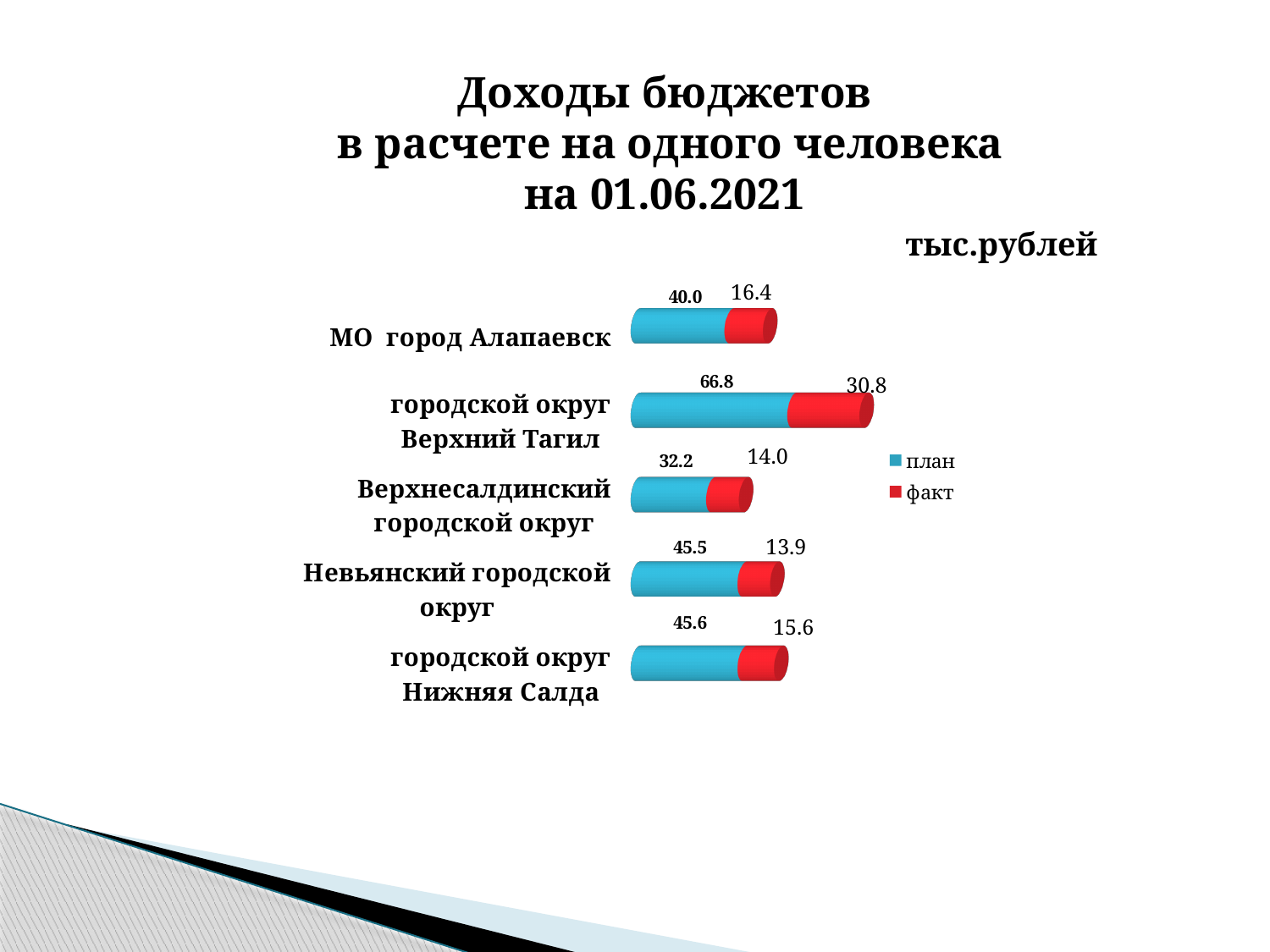
Which category has the highest план value? городской округ Верхний Тагил What is the план value for городской округ Верхний Тагил? 66.8 What is the факт value for МО город Алапаевск? 16.4 Which category has the lowest план value? Верхнесалдинский городской округ What is the план value for Верхнесалдинский городской округ? 32.2 What is the факт value for городской округ Нижняя Салда? 15.6 Which is larger for Невьянский городской округ: the план value or the факт value? план Which category has the highest факт value? городской округ Верхний Тагил How many series does the legend list? 2 What is the difference between the план and факт values for городской округ Верхний Тагил? 36.0 What type of chart is shown on the slide? bar chart How many categories are shown in the chart? 5